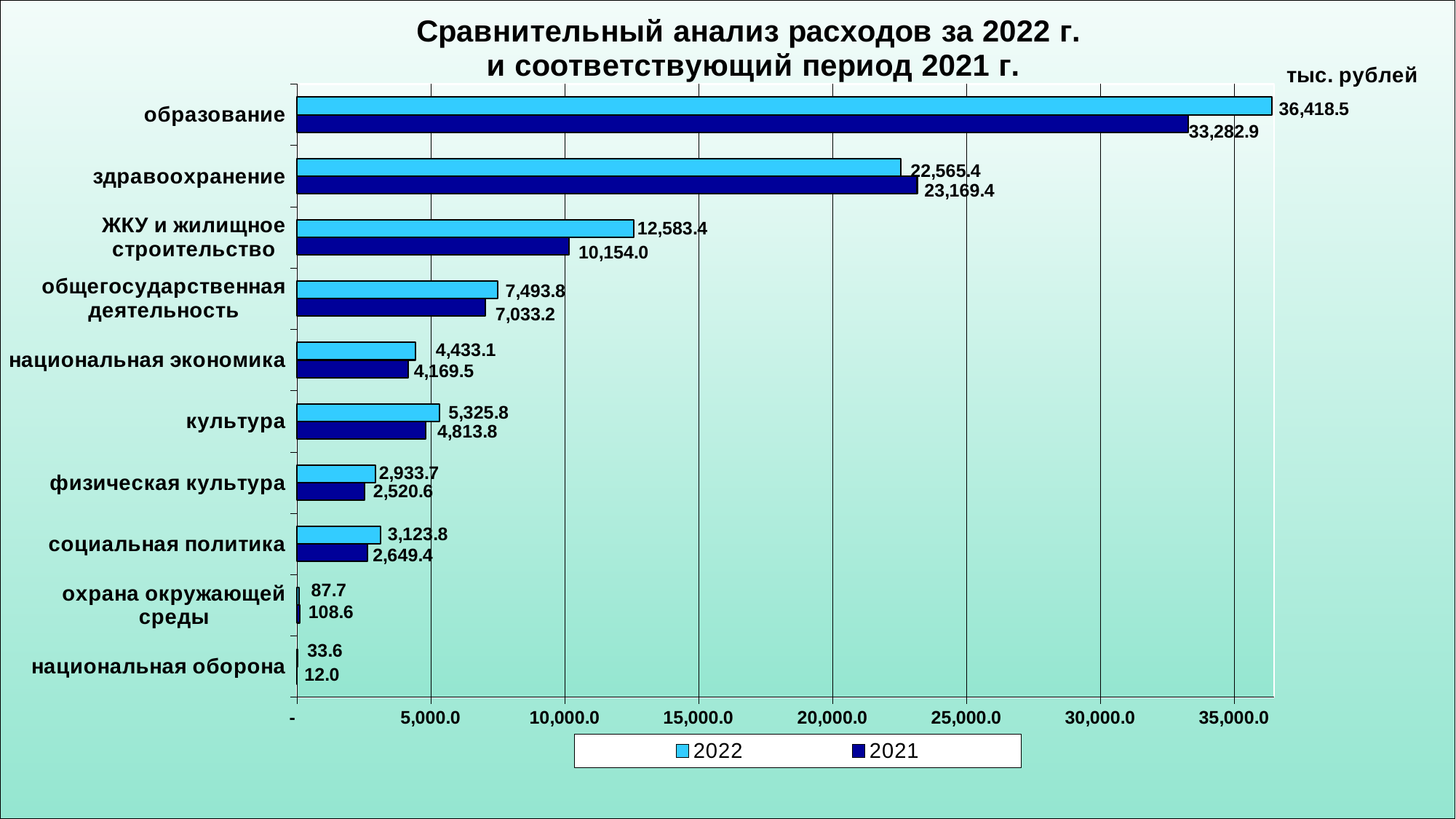
What is the 2021 value for здравоохранение? 23,169.4 What is the 2022 value for образование? 36,418.5 Which category has the highest 2022 value? образование Which is larger for здравоохранение: the 2022 value or the 2021 value? 2021 What unit is indicated in the top right corner of the chart? тыс. рублей How many categories are shown on the chart? 10 What is the 2022 value for ЖКУ и жилищное строительство? 12,583.4 Which category has the lowest 2021 value? национальная оборона How many series does the legend list? 2 What is the difference between the 2022 and 2021 values for образование? 3,135.6 What is the 2021 value for национальная оборона? 12.0 What type of chart is shown on the slide? bar chart